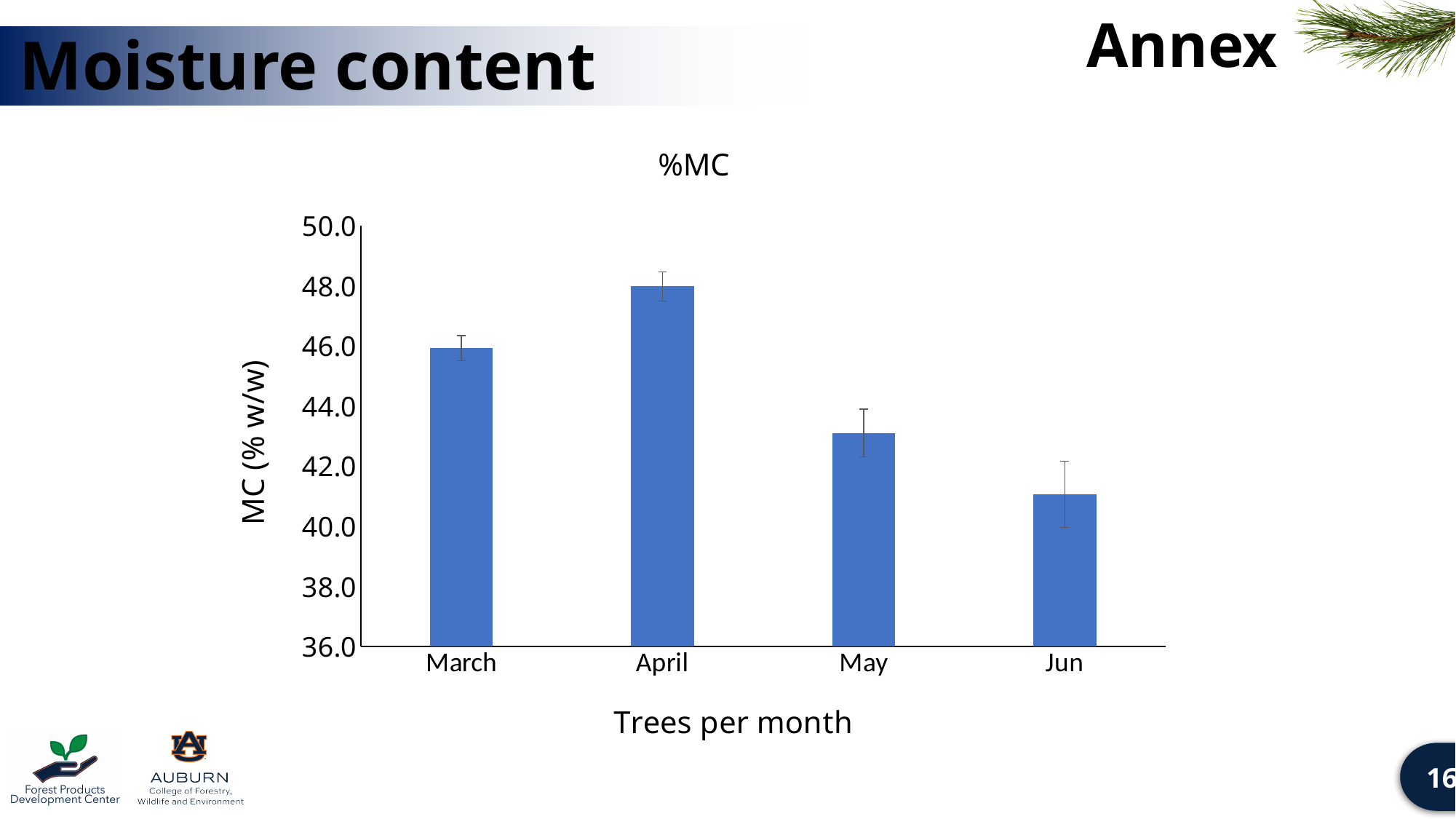
What is the label on the x axis? Trees per month Which is larger, the value for March or the value for May? March How many categories are plotted on the x axis? 4 Is the value for March greater or less than 44.0? greater Which month has the lowest moisture content? Jun Is the value for Jun greater or less than 42.0? less Which month has the highest moisture content? April Do the values rise or fall from April to Jun? fall Is the value for April greater or less than 46.0? greater What is the title of the chart? %MC What kind of chart is shown on the slide? bar chart